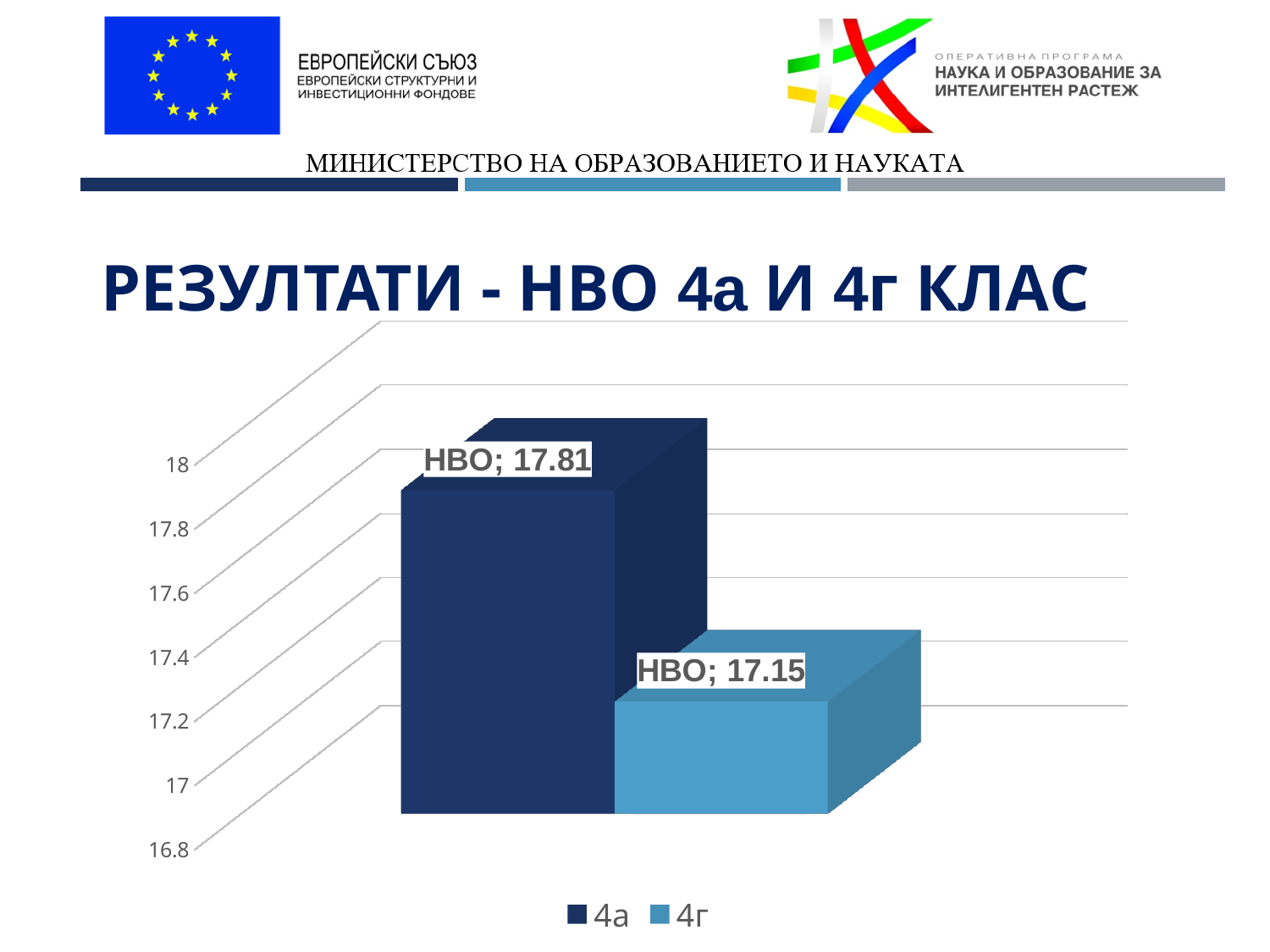
Which series is shown in dark blue in the legend? 4а How many series does the legend list? 2 What is the НВО value for class 4г? 17.15 Which series has the highest value on the chart? 4а What is the title of the slide above the chart? РЕЗУЛТАТИ - НВО 4а И 4г КЛАС What kind of chart is shown on the slide? bar chart Is the value for 4г greater or less than 17.4? less What is the НВО value for class 4а? 17.81 What is the difference between the НВО results of 4а and 4г? 0.66 Which class has the higher НВО result, 4а or 4г? 4а Which series has the lowest value on the chart? 4г Is the value for 4а greater or less than 17.6? greater